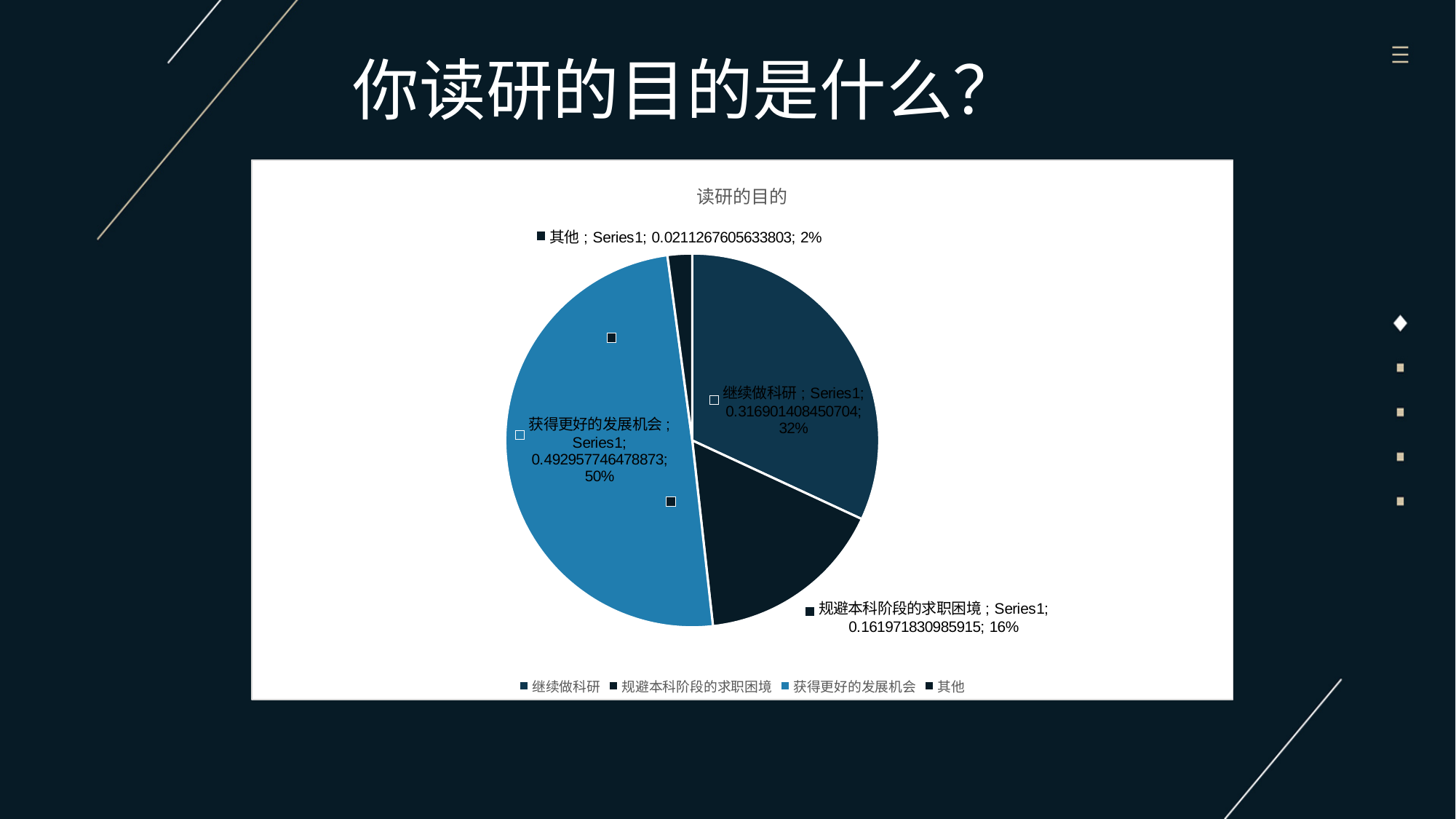
What percentage share does 获得更好的发展机会 have in the pie chart? 50% What percentage share does 其他 have in the pie chart? 2% What is the data value printed for 继续做科研? 0.316901408450704 What is the title of the chart? 读研的目的 Which category has the smallest slice of the pie? 其他 What kind of chart is shown on the slide? pie chart How many slices does the pie chart have? 4 Which category has the largest slice of the pie? 获得更好的发展机会 What percentage share does 继续做科研 have in the pie chart? 32% What is the data value printed for 其他? 0.0211267605633803 What is the difference in percentage points between the shares of 继续做科研 and 规避本科阶段的求职困境? 16%